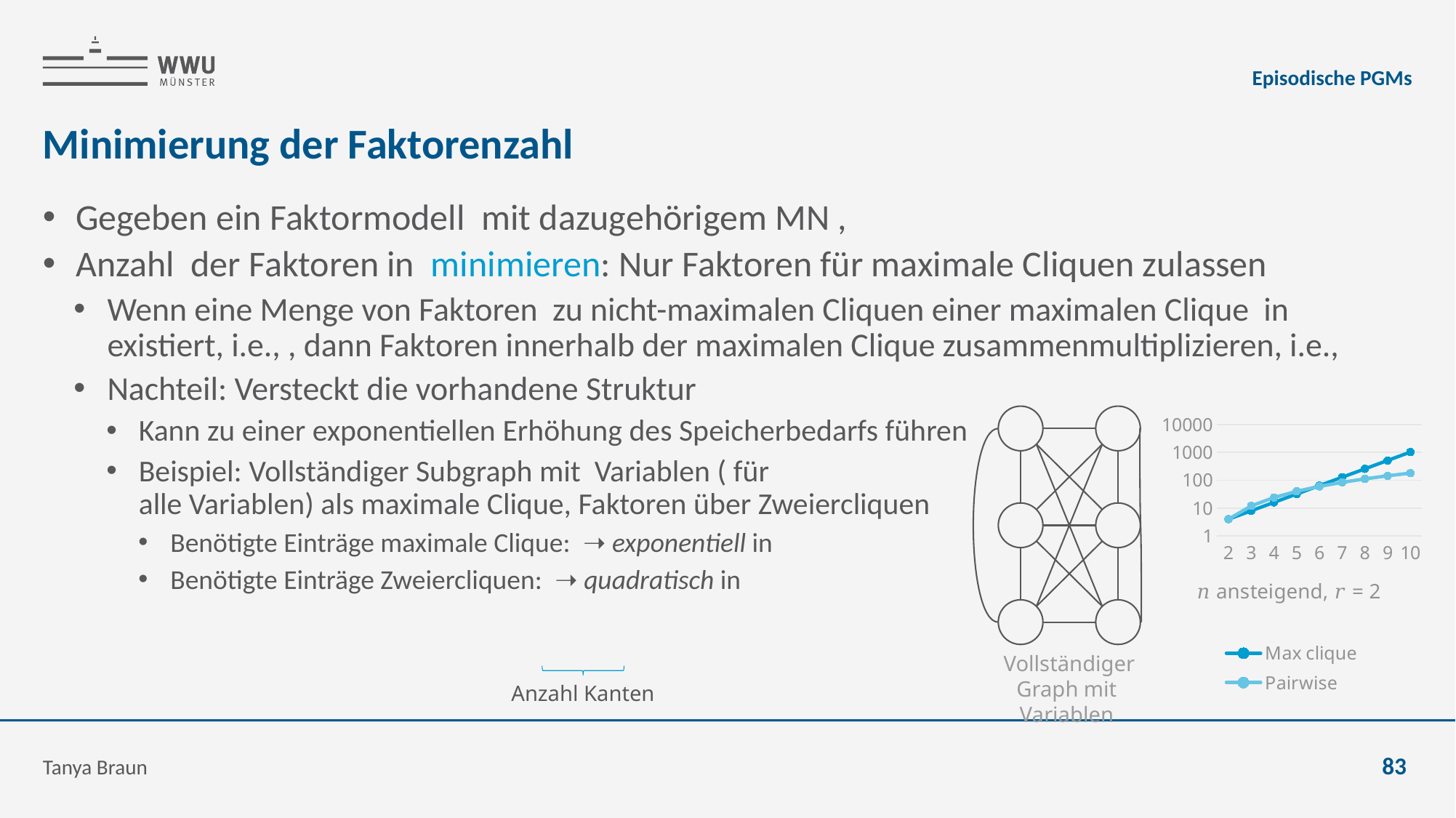
Do the values of the Pairwise series rise or fall as n increases along the x axis? rise How many x-axis values are plotted in the chart? 9 What kind of chart is shown on the right of the slide? line chart How many series does the legend of the chart list? 2 At n = 10, which series has the larger value, Max clique or Pairwise? Max clique What are the two series named in the chart legend? Max clique and Pairwise Do the values of the Max clique series rise or fall as n increases along the x axis? rise Is the value of the Max clique series at n = 2 greater or less than 10? less Is the value of the Pairwise series at n = 10 greater or less than 1000? less At n = 8, which series has the larger value, Max clique or Pairwise? Max clique What is the highest tick label shown on the y axis of the chart? 10000 Is the value of the Max clique series at n = 10 greater or less than 100? greater